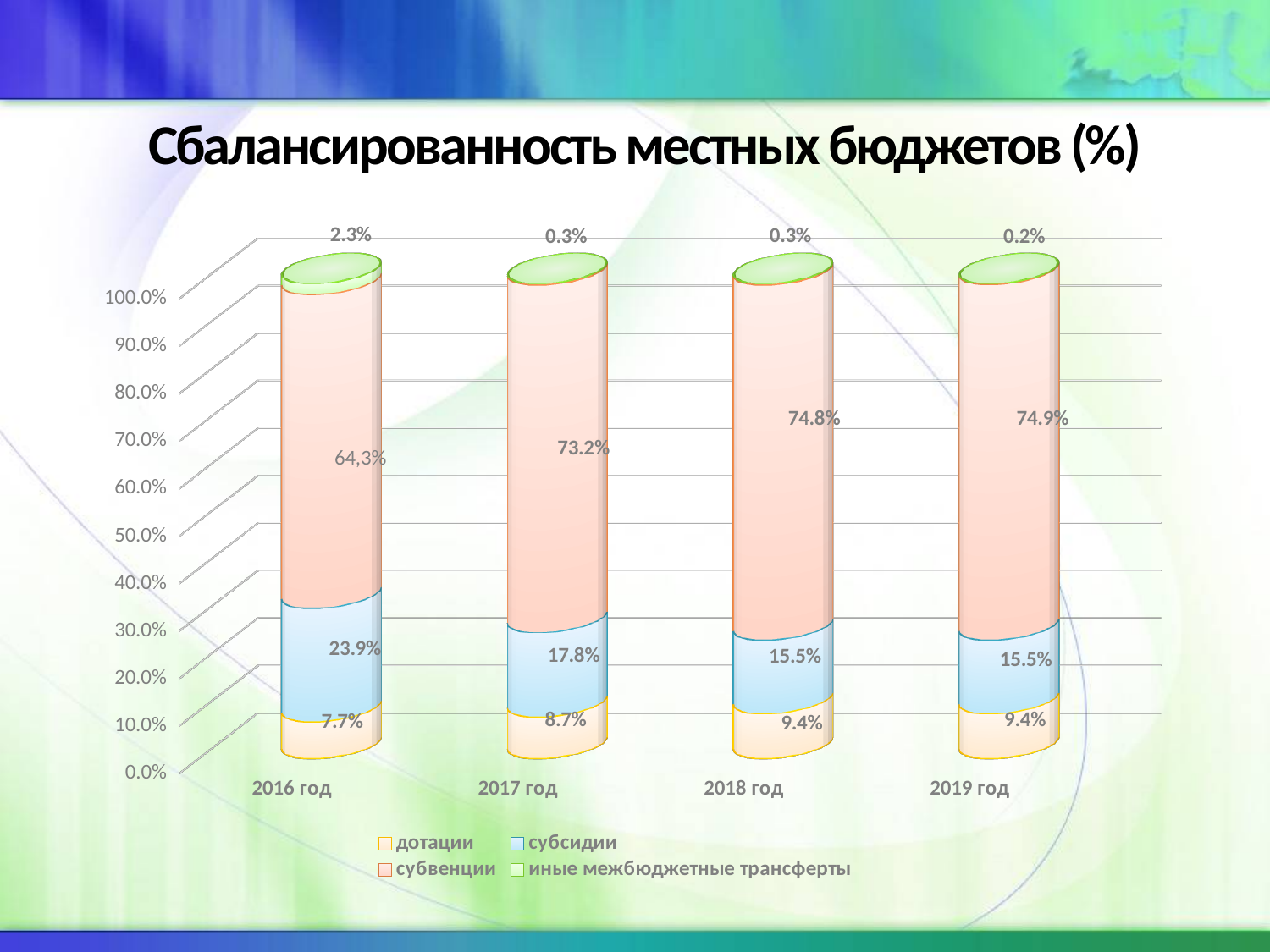
What is the value for дотации in 2016 год? 7.7% Do the values for субсидии rise or fall from 2016 год to 2018 год? fall What is the value for субсидии in 2019 год? 15.5% What kind of chart is shown on the slide? stacked bar chart In which year is the value for субсидии the highest? 2016 год How many series does the legend list? 4 What is the value for субвенции in 2017 год? 73.2% How many years are shown on the x axis? 4 Which is larger: дотации in 2017 год or дотации in 2018 год? 2018 год What is the value for иные межбюджетные трансферты in 2016 год? 2.3% What is the difference between the субвенции values for 2018 год and 2017 год? 1.6% In which year is the value for иные межбюджетные трансферты the lowest? 2019 год